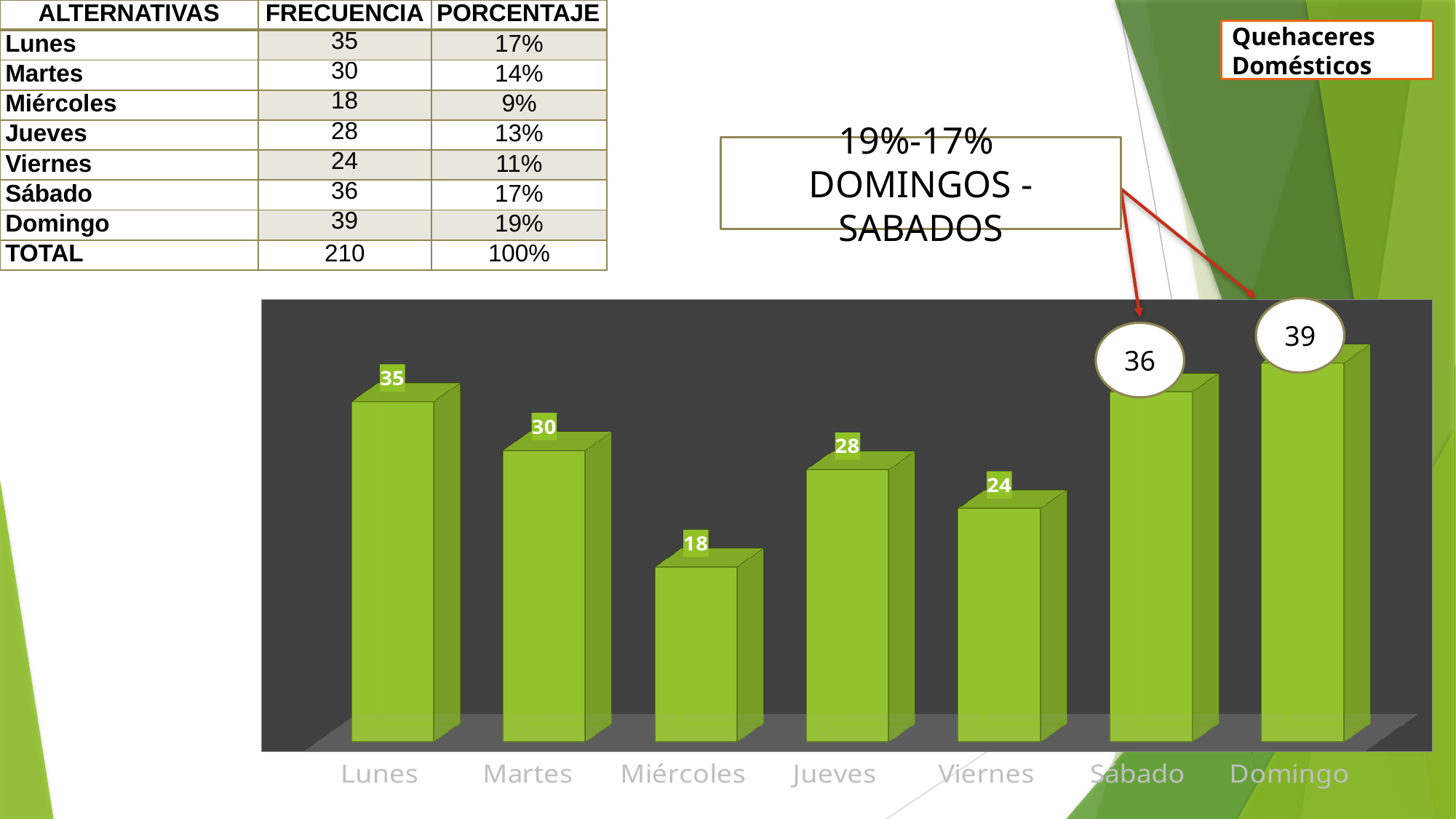
Which day has the highest value in the bar chart? Domingo What is the difference between the values for Domingo and Sábado in the bar chart? 3 What colour are the bars in the chart? green Which is larger in the bar chart, the value for Jueves or the value for Viernes? Jueves What is the value for Domingo in the bar chart? 39 What is the difference between the values for Lunes and Miércoles in the bar chart? 17 What kind of chart is shown on the slide? bar chart What is the value for Lunes in the bar chart? 35 What is the value for Miércoles in the bar chart? 18 What is the value for Viernes in the bar chart? 24 Which day has the lowest value in the bar chart? Miércoles How many days (categories) are shown in the bar chart? 7